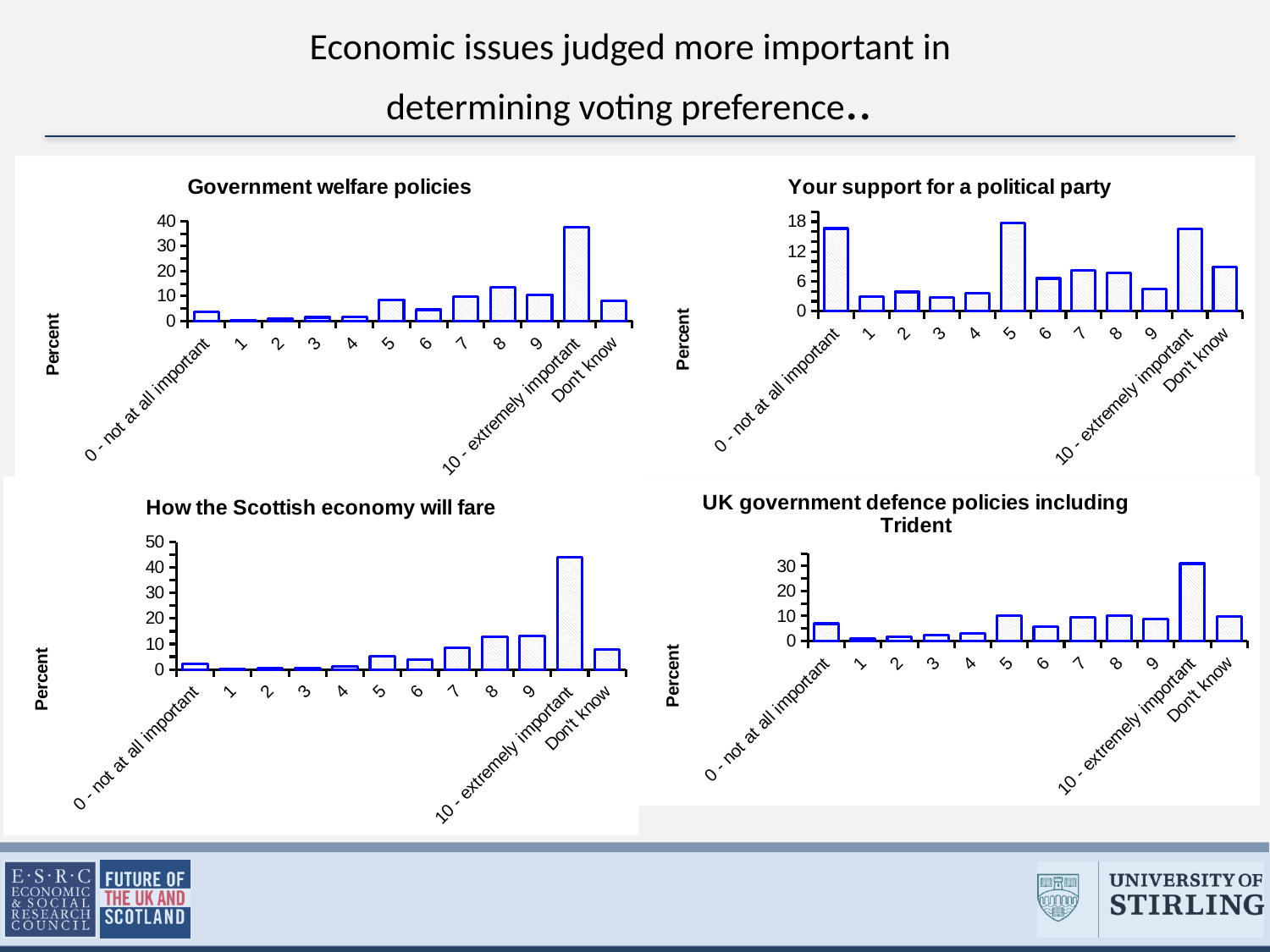
In the 'Government welfare policies' chart, which category has the highest value? 10 - extremely important How many categories are shown on the x axis of the 'Government welfare policies' chart? 12 In the 'Your support for a political party' chart, is the value for category 5 greater or less than 12? greater In the 'Your support for a political party' chart, is the value for category 1 greater or less than 6? less In the 'How the Scottish economy will fare' chart, which category has the highest value? 10 - extremely important In the 'Your support for a political party' chart, which is larger: the value for category 5 or the value for category 2? 5 In the 'How the Scottish economy will fare' chart, is the value for '10 - extremely important' greater or less than 40? greater What kind of chart is 'How the Scottish economy will fare'? Bar chart In the 'UK government defence policies including Trident' chart, which category has the highest value? 10 - extremely important